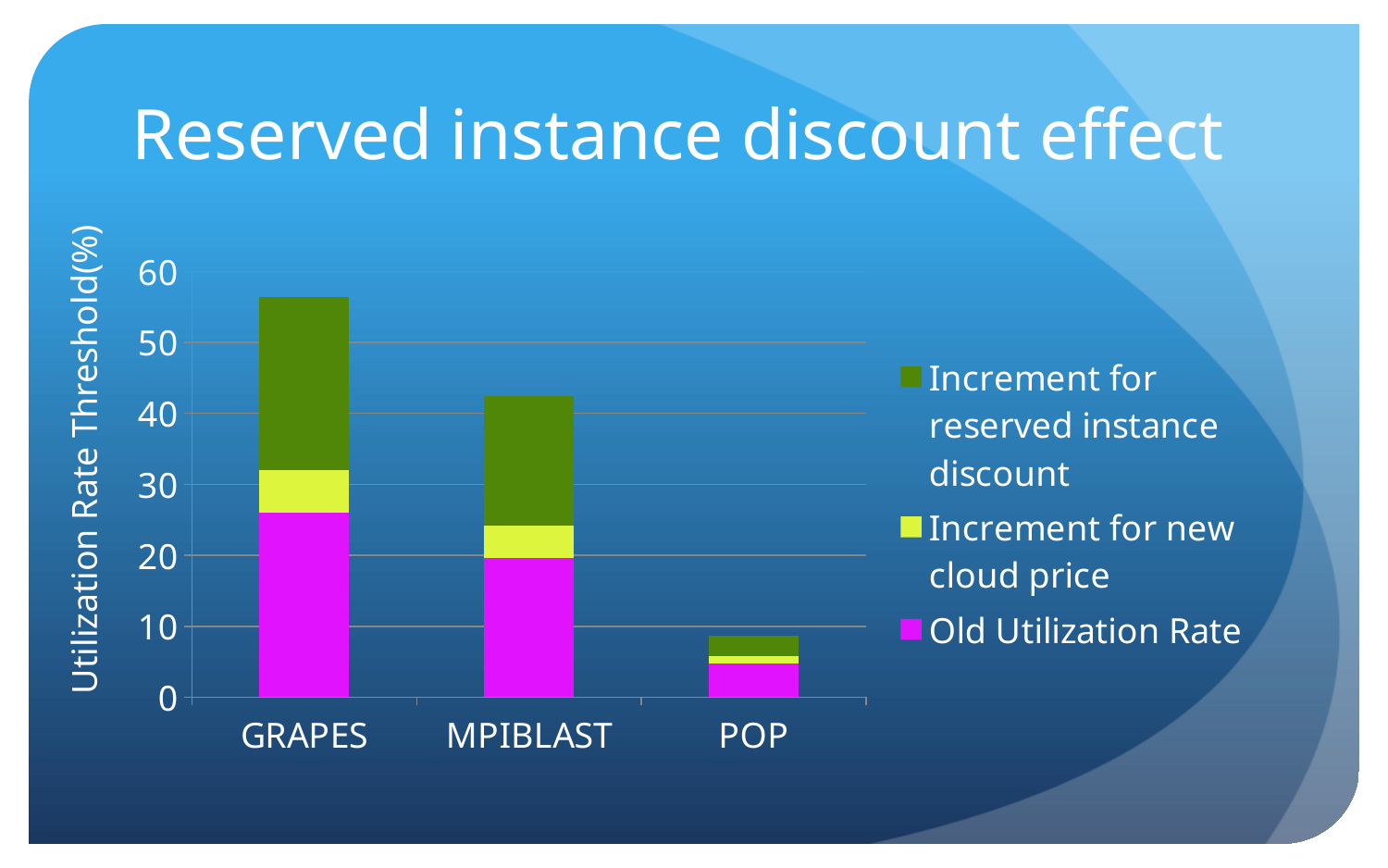
Is the total stacked value for POP greater or less than 10? less Is the Old Utilization Rate value for GRAPES greater or less than 20? greater How many categories are shown on the x axis? 3 Which is larger, the Old Utilization Rate for GRAPES or for MPIBLAST? GRAPES Do the total stacked values rise or fall from GRAPES to POP along the x axis? fall Which category has the highest total stacked bar? GRAPES Which category has the lowest total stacked bar? POP Is the total stacked value for MPIBLAST greater or less than 30? greater How many series does the legend list? 3 What is the label of the y axis? Utilization Rate Threshold(%) What kind of chart is shown on the slide? Stacked bar chart